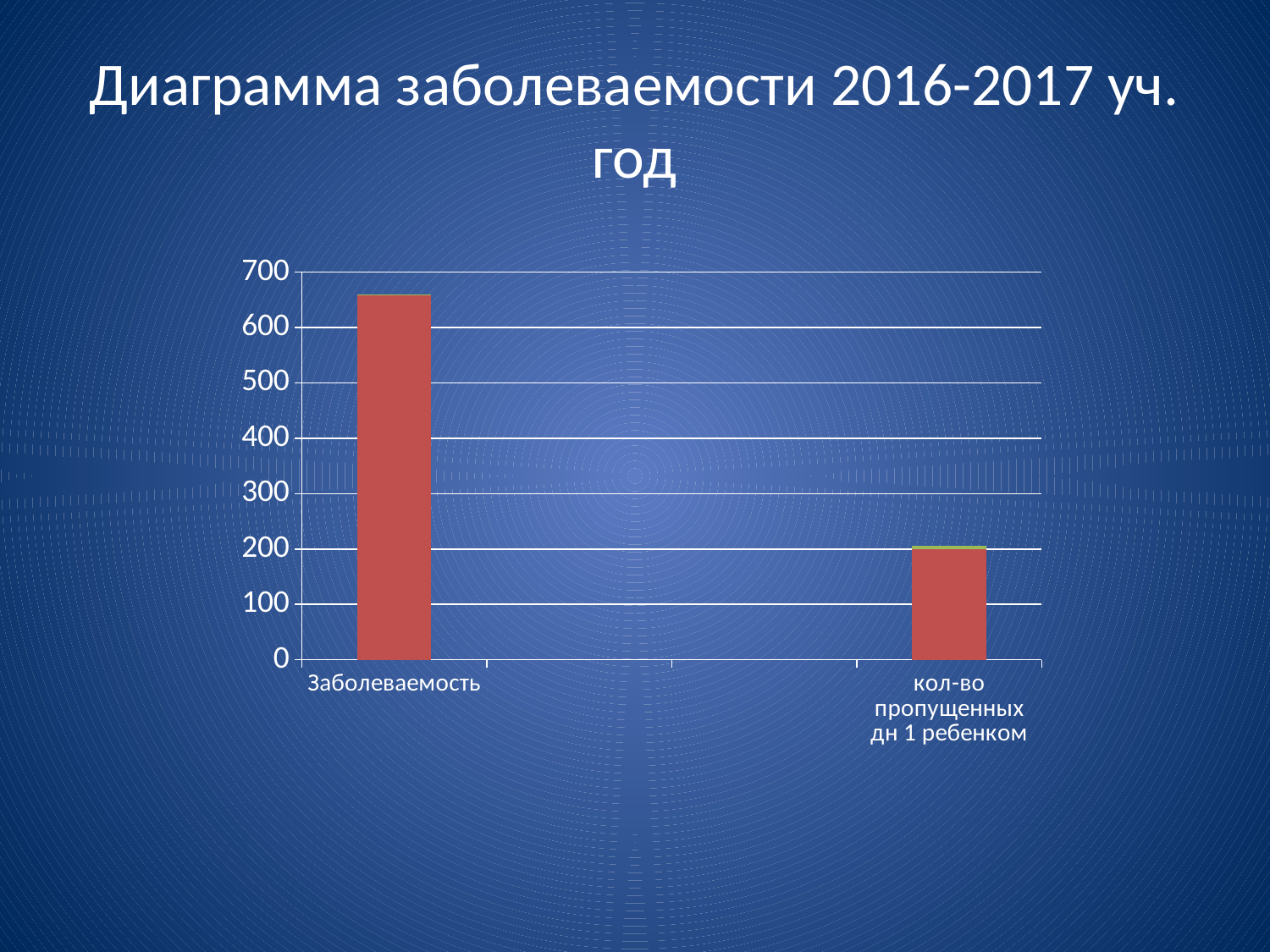
Which is larger, the value for Заболеваемость or the value for кол-во пропущенных дн 1 ребенком? Заболеваемость Which category has the highest bar? Заболеваемость Is the value for Заболеваемость greater or less than 700? less Is the value for Заболеваемость greater or less than 600? greater Which category has the lowest bar? кол-во пропущенных дн 1 ребенком What colour are the bars in the chart? red Is the value for кол-во пропущенных дн 1 ребенком greater or less than 100? greater Do the bar values rise or fall from left to right along the x axis? fall How many categories are plotted on the chart? 2 What is the title of the slide containing the chart? Диаграмма заболеваемости 2016-2017 уч. год What kind of chart is shown on the slide? bar chart